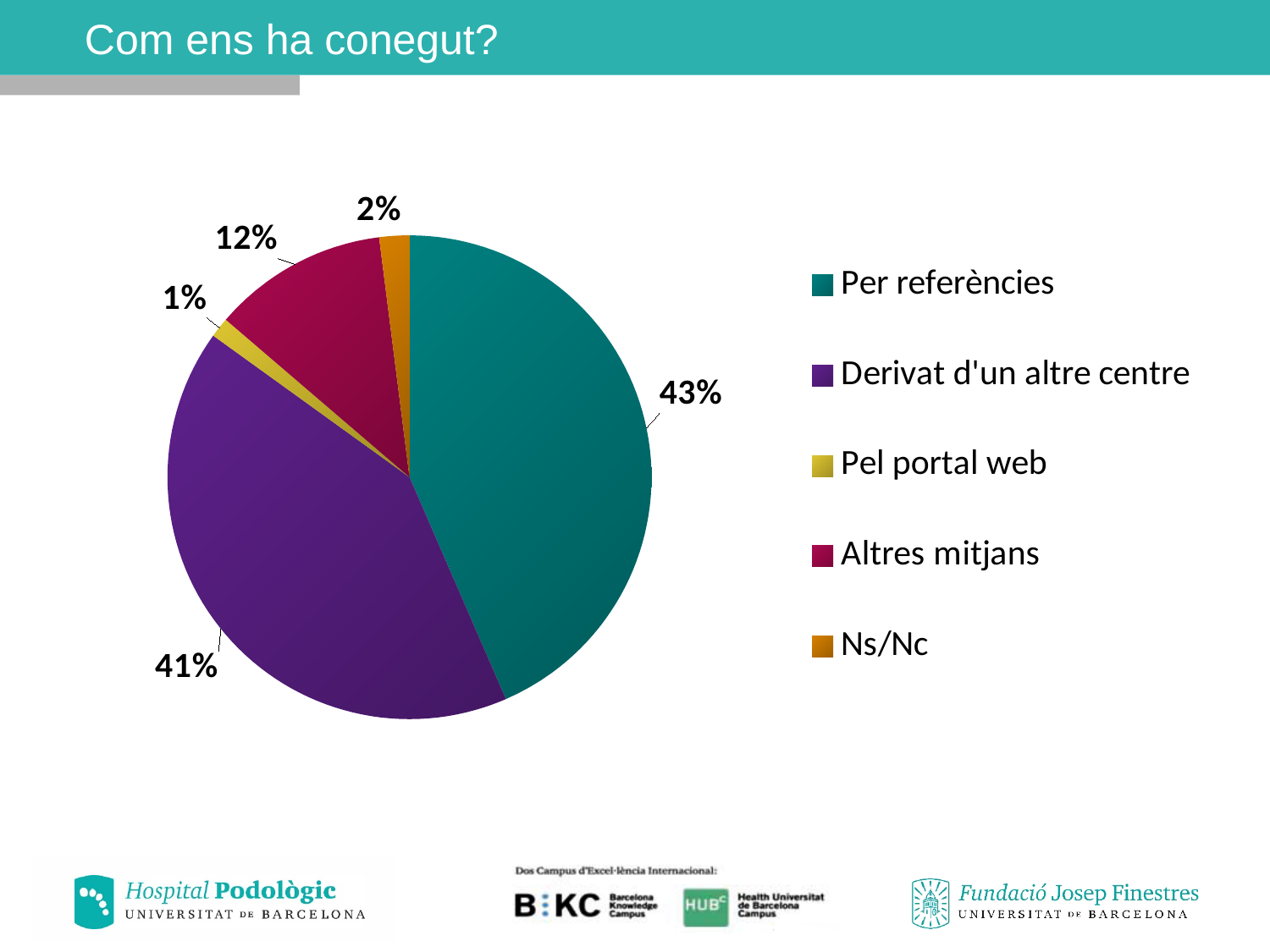
What is the title of the slide containing the chart? Com ens ha conegut? What is the difference between the shares of "Per referències" and "Derivat d'un altre centre"? 2% Which category has the largest slice of the pie? Per referències Which is larger, the share for "Altres mitjans" or the share for "Ns/Nc"? Altres mitjans What is the value for "Altres mitjans"? 12% What share of the pie does "Per referències" represent? 43% How many categories does the legend list? 5 What is the value for "Ns/Nc"? 2% What is the value for "Pel portal web"? 1% Which category has the smallest slice of the pie? Pel portal web What kind of chart is shown on the slide? pie chart What share of the pie does "Derivat d'un altre centre" represent? 41%